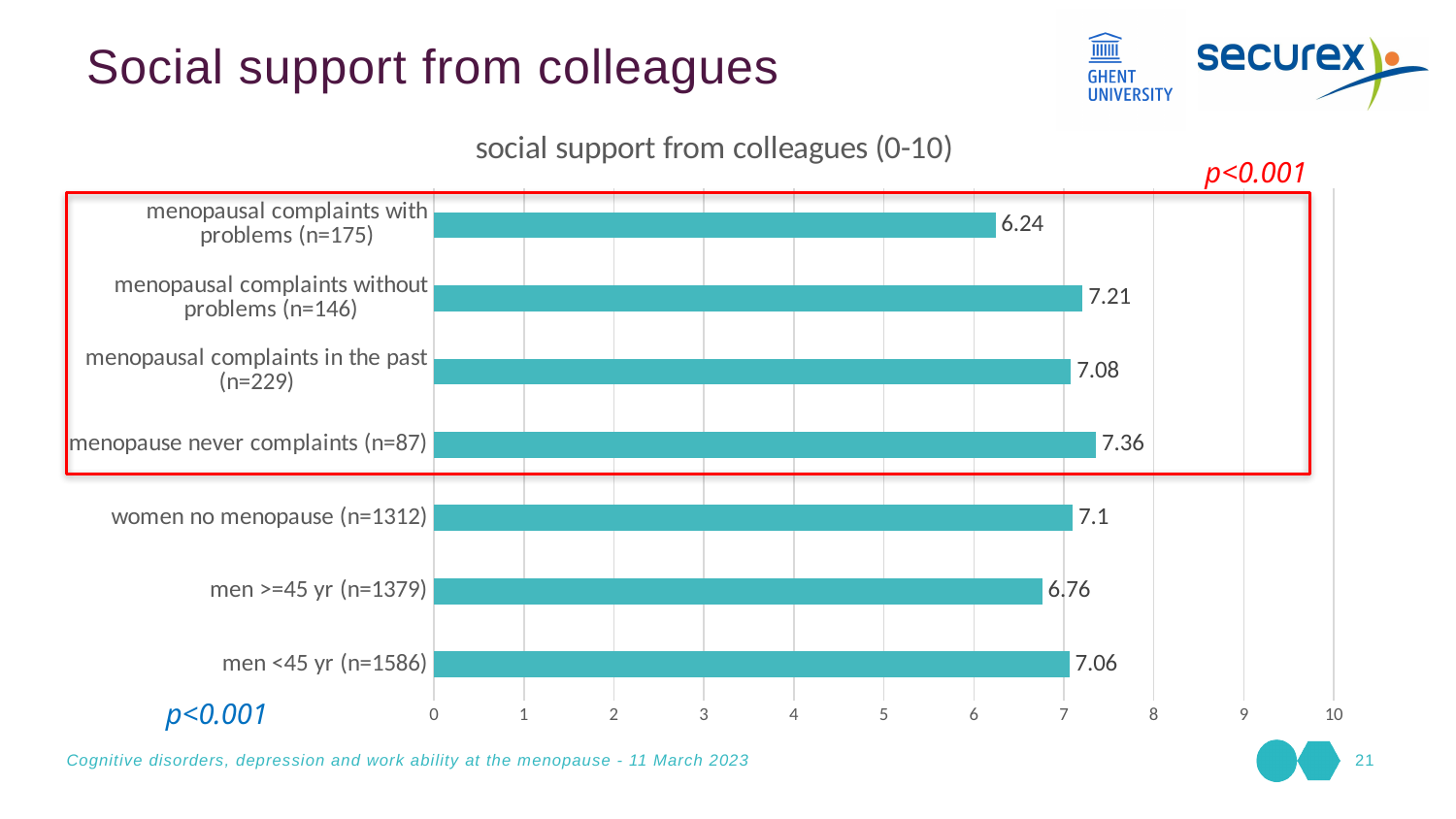
What is the title of the chart? social support from colleagues (0-10) What kind of chart is shown on the slide? bar chart What is the maximum value shown on the x axis of the chart? 10 Is the value for men <45 yr (n=1586) greater or less than 6? greater Which category has the highest social support from colleagues score? menopause never complaints (n=87) What is the difference between the values for menopause never complaints (n=87) and menopausal complaints with problems (n=175)? 1.12 What is the value for women no menopause (n=1312)? 7.1 Which is larger: the value for menopausal complaints without problems (n=146) or menopausal complaints in the past (n=229)? menopausal complaints without problems (n=146) How many categories are shown in the chart? 7 Which category has the lowest social support from colleagues score? menopausal complaints with problems (n=175) What is the social support from colleagues score for menopausal complaints with problems (n=175)? 6.24 What is the value for men >=45 yr (n=1379)? 6.76